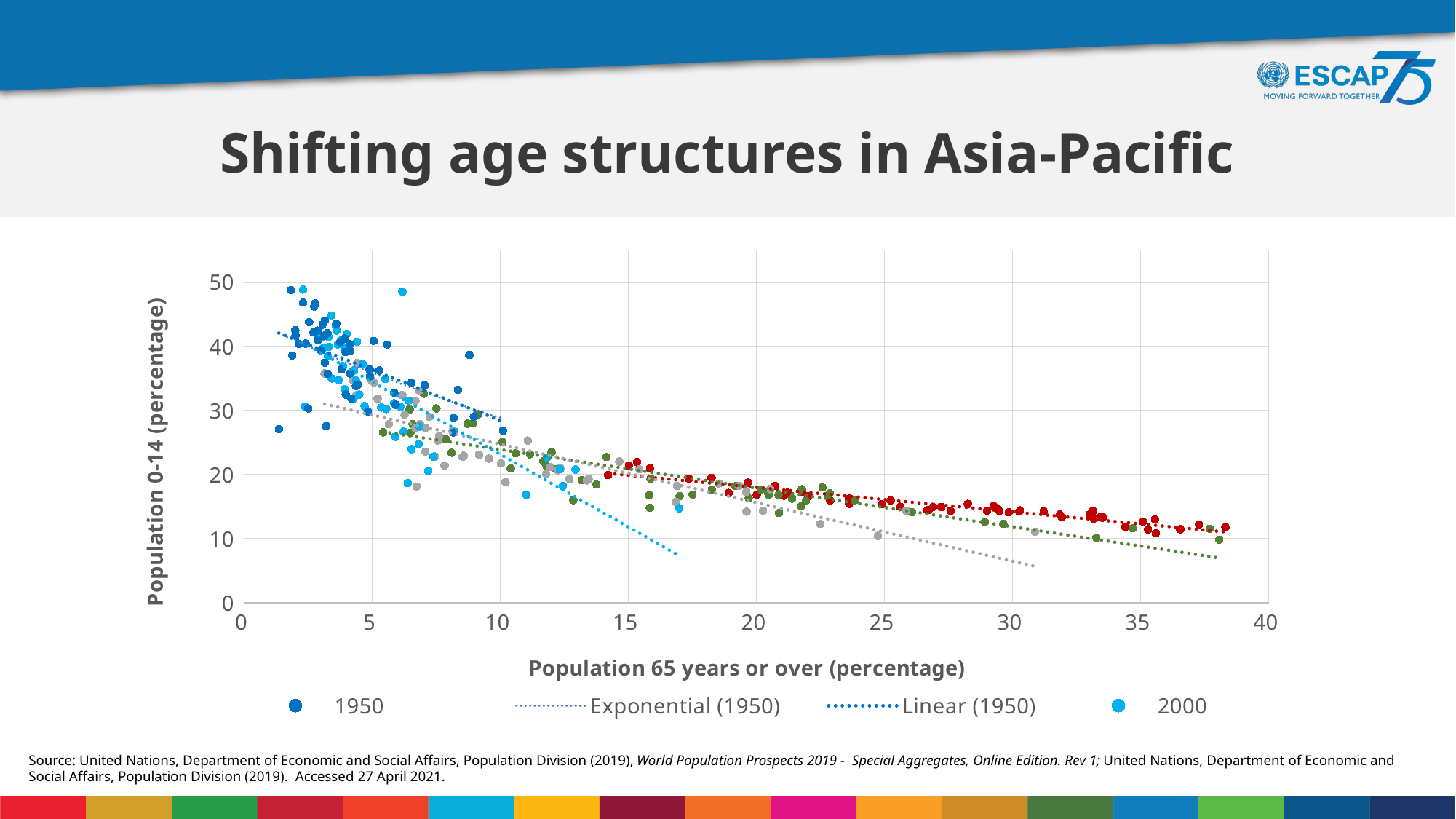
Which legend series has its points clustered at the lowest x-axis values (below 15)? 1950 What is the label of the chart's x axis? Population 65 years or over (percentage) Which two years are plotted as point series in the chart's legend? 1950 and 2000 As the share of population aged 65 or over increases along the x axis, do the plotted values for population aged 0-14 generally rise or fall? Fall What is the highest value shown on the chart's y axis? 50 What kind of chart is shown on the slide? Scatter chart Do the 1950 points on the chart mostly lie above or below 30 on the y axis? Above What is the title of the chart on the slide? Shifting age structures in Asia-Pacific What is the highest value shown on the chart's x axis? 40 How many entries does the chart's legend list? 4